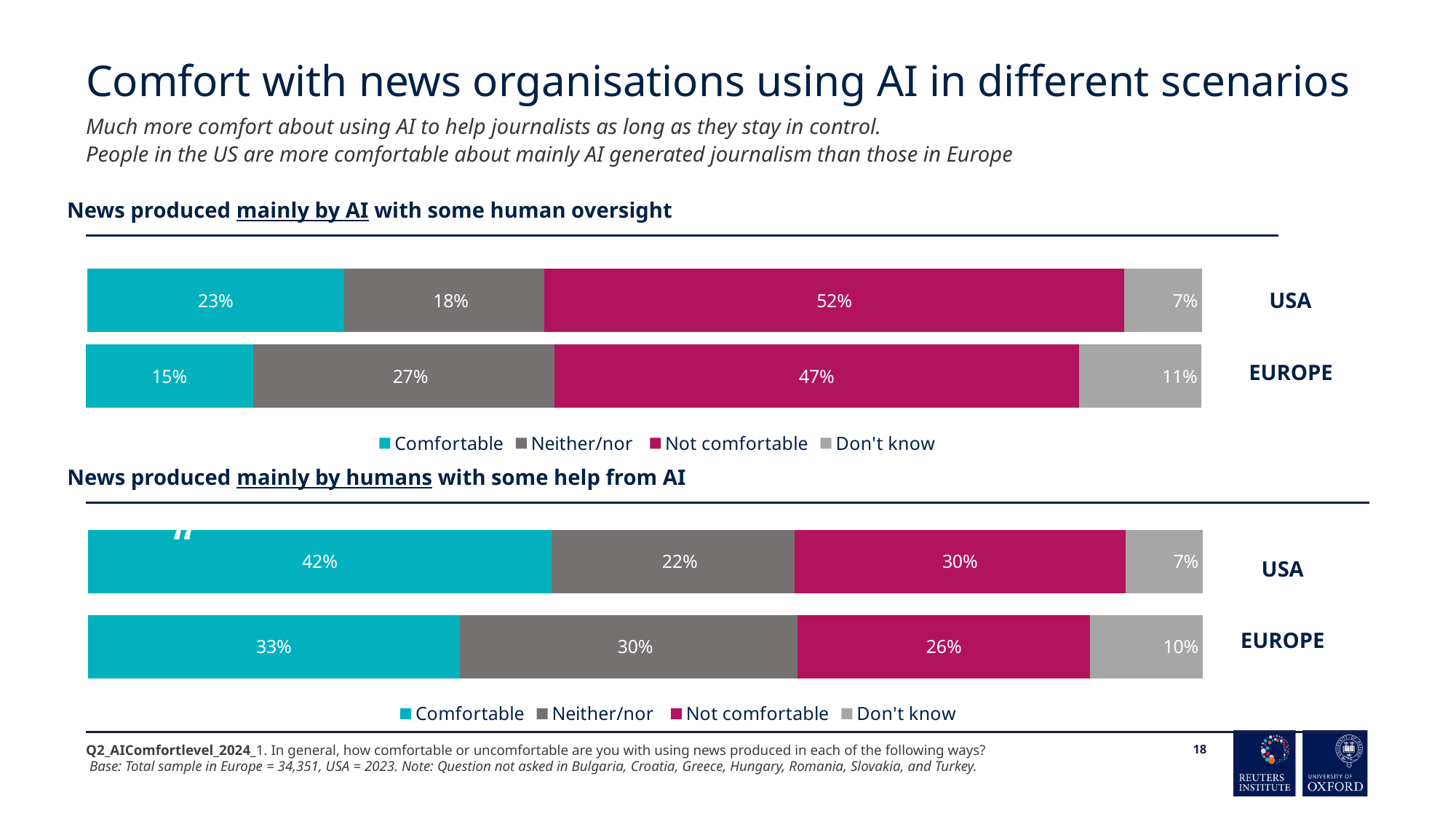
In the 'News produced mainly by AI with some human oversight' chart, which response category has the largest share for the USA? Not comfortable How many series does the legend of the 'News produced mainly by AI with some human oversight' chart list? 4 In the 'News produced mainly by humans with some help from AI' chart, what percentage of USA respondents are Comfortable? 42% In the 'News produced mainly by humans with some help from AI' chart, what colour represents Not comfortable? Magenta In the 'News produced mainly by humans with some help from AI' chart, which response category has the smallest share for Europe? Don't know In the 'News produced mainly by AI with some human oversight' chart, what percentage of Europe respondents are Comfortable? 15% What kind of chart is used for 'News produced mainly by AI with some human oversight'? Stacked bar chart In the 'News produced mainly by AI with some human oversight' chart, what percentage of USA respondents are Not comfortable? 52% In the 'News produced mainly by humans with some help from AI' chart, what percentage of Europe respondents answered Don't know? 10% In the 'News produced mainly by humans with some help from AI' chart, which has a larger Not comfortable share, USA or Europe? USA In the 'News produced mainly by AI with some human oversight' chart, what is the difference between the Neither/nor shares for Europe and the USA? 9 percentage points How many bars are shown in the 'News produced mainly by humans with some help from AI' chart? 2